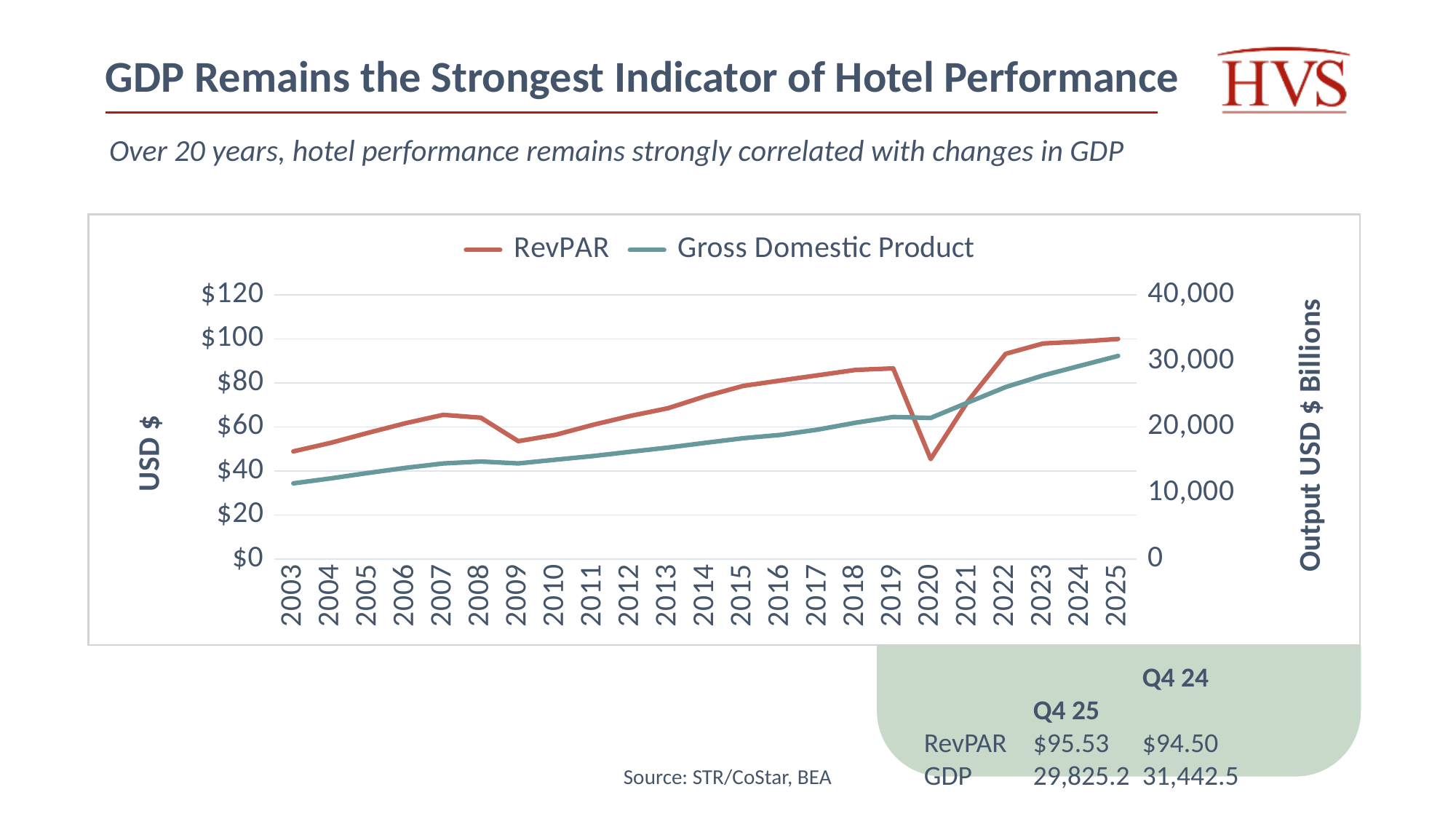
How many series does the chart legend list? 2 Does the Gross Domestic Product line generally rise or fall from 2003 to 2025? Rise Which year has the lowest Gross Domestic Product value on the chart? 2003 Is the Gross Domestic Product value for 2015 greater or less than 20,000? less How many years are plotted along the x axis of the chart? 23 What kind of chart is shown on the slide? Line chart Which year has the highest Gross Domestic Product value on the chart? 2025 Is the RevPAR value for 2019 greater or less than $80? greater Which year has the lowest RevPAR value on the chart? 2020 Which is larger, the RevPAR value for 2007 or for 2009? 2007 Is the RevPAR value for 2020 greater or less than $60? less What is the title of the right-hand vertical axis of the chart? Output USD $ Billions